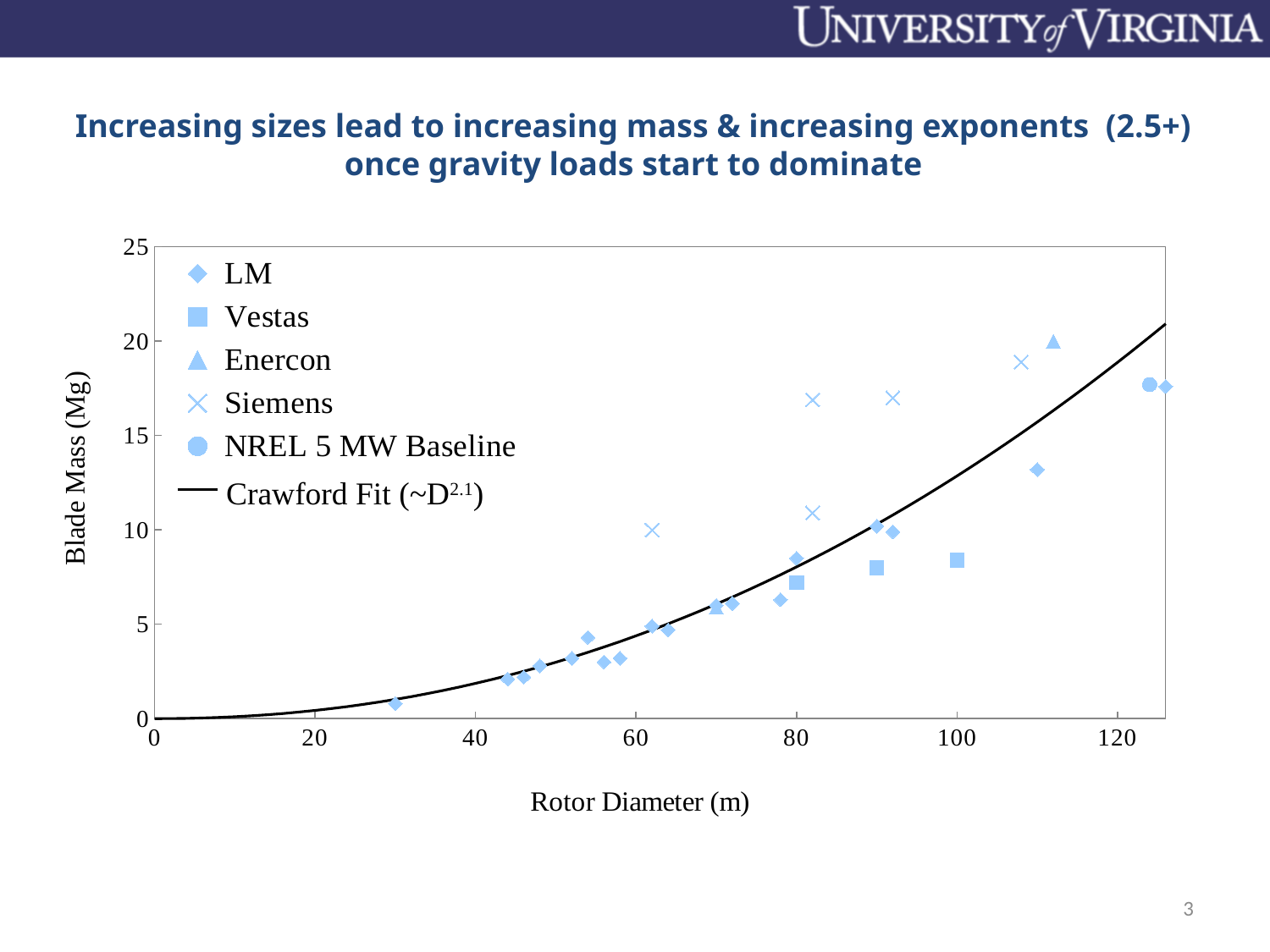
Does blade mass rise or fall as rotor diameter increases along the x axis? Rise Is the blade mass of the Vestas point at a rotor diameter of 100 m greater or less than 10? less How many Vestas data points are plotted? 3 Is the blade mass of the NREL 5 MW Baseline point greater or less than 15? greater How many entries does the legend list? 6 How many Enercon data points are plotted? 2 What is the label on the vertical axis? Blade Mass (Mg) What kind of chart is shown on the slide? Scatter chart What exponent is given for the Crawford Fit in the legend? ~D^2.1 Which series has the highest blade mass point on the chart? Enercon Which has the higher blade mass, the Enercon point or the NREL 5 MW Baseline point? Enercon